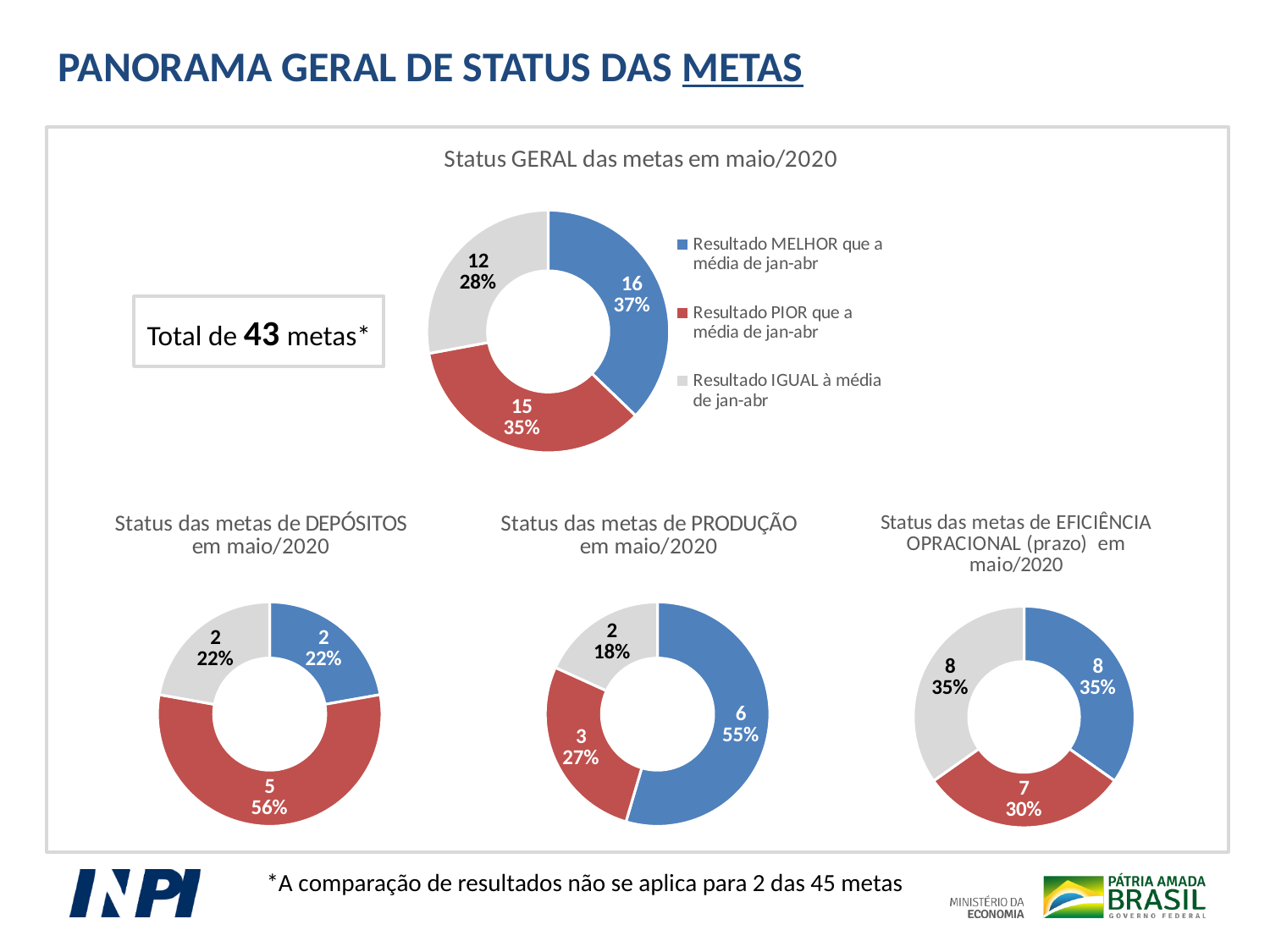
In the chart 'Status GERAL das metas em maio/2020', which category has the smallest number of metas? Resultado IGUAL à média de jan-abr How many categories does the legend of the chart 'Status GERAL das metas em maio/2020' list? 3 What type of chart is 'Status GERAL das metas em maio/2020'? Donut (pie) chart In the chart 'Status GERAL das metas em maio/2020', what percentage of metas had a result PIOR (worse) than the jan-abr average? 35% In the chart 'Status das metas de DEPÓSITOS em maio/2020', how many metas are in the red (PIOR) slice? 5 In the chart 'Status GERAL das metas em maio/2020', how many metas had a result MELHOR (better) than the jan-abr average? 16 In the chart 'Status GERAL das metas em maio/2020', what is the difference between the number of metas with a MELHOR result and the number with an IGUAL result? 4 In the chart 'Status das metas de PRODUÇÃO em maio/2020', which slice is the largest? The blue slice (Resultado MELHOR), 6 (55%) In the chart 'Status das metas de EFICIÊNCIA OPRACIONAL (prazo) em maio/2020', how many metas are in the red (PIOR) slice? 7 In the chart 'Status das metas de PRODUÇÃO em maio/2020', what percentage is shown for the grey (IGUAL) slice? 18% In the chart 'Status das metas de EFICIÊNCIA OPRACIONAL (prazo) em maio/2020', what is the total number of metas across all three slices? 23 In the chart 'Status das metas de DEPÓSITOS em maio/2020', what share of the metas does the red (PIOR) slice represent? 56%